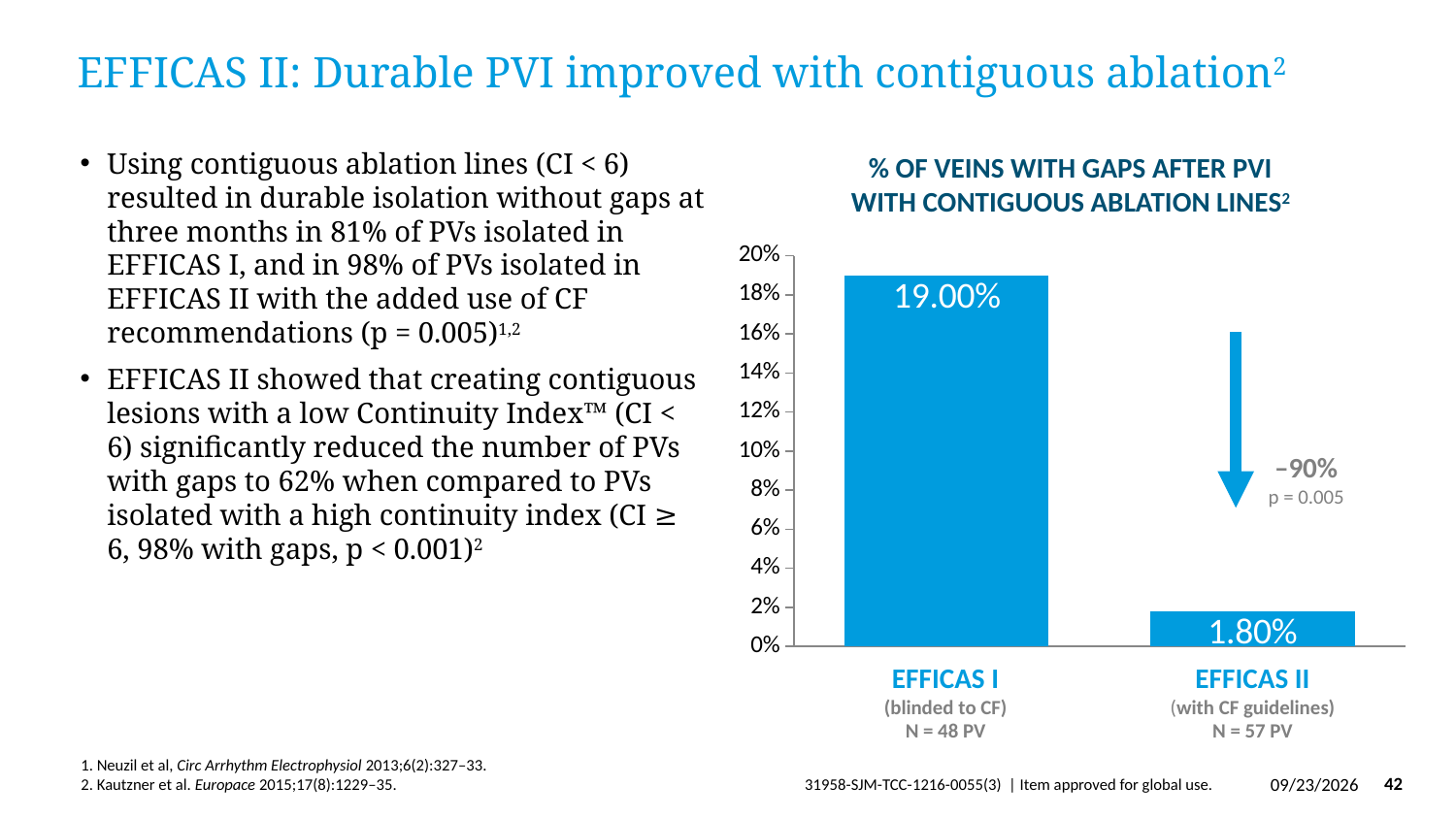
What is the value for EFFICAS I in the chart? 19.00% Is the value for EFFICAS I greater or less than 10%? greater What kind of chart is shown on the slide? bar chart What percentage change is annotated by the arrow between the two bars? -90% Which category has the highest value in the chart? EFFICAS I What is the title of the chart? % of veins with gaps after PVI with contiguous ablation lines Which is larger, the value for EFFICAS I or for EFFICAS II? EFFICAS I What is the difference between the EFFICAS I and EFFICAS II values? 17.20% How many categories are shown in the chart? 2 Which category has the lowest value in the chart? EFFICAS II Is the value for EFFICAS II greater or less than 4%? less What is the value for EFFICAS II in the chart? 1.80%